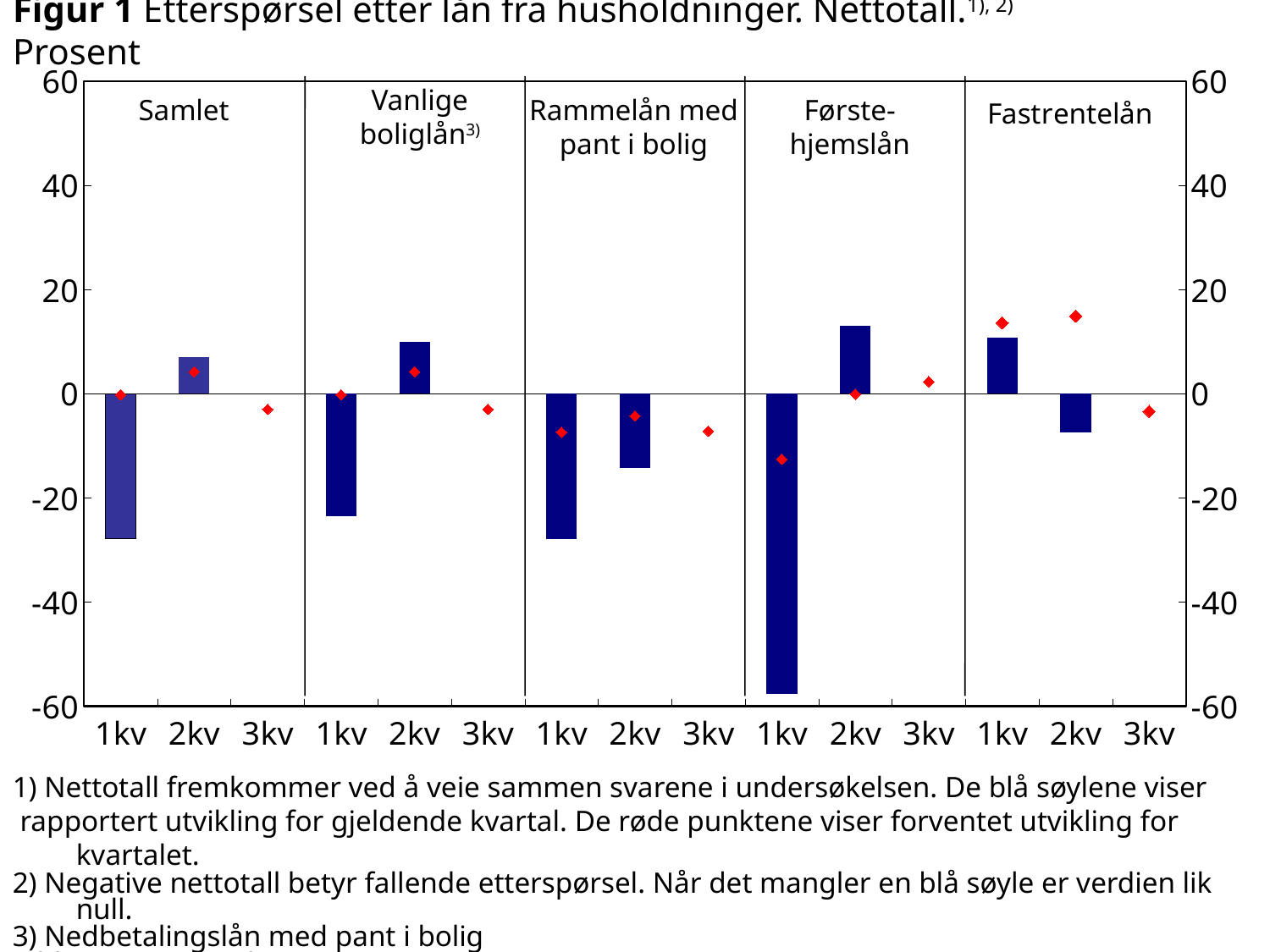
How many quarters are shown on the x axis within each panel? 3 In the Samlet panel, does the blue bar rise or fall from 1kv to 2kv? rise What kind of chart is shown in Figur 1? bar chart In the Rammelån med pant i bolig panel, which quarter has the larger blue bar value, 1kv or 2kv? 2kv Which is larger, the 2kv blue bar in the Samlet panel or the 2kv blue bar in the Førstehjemslån panel? Førstehjemslån Is the blue bar for 1kv in the Førstehjemslån panel greater or less than -40? less Is the blue bar for 2kv in the Rammelån med pant i bolig panel greater or less than -20? greater Is the blue bar for 1kv in the Samlet panel greater or less than -20? less Which panel and quarter has the lowest blue bar in the chart? Førstehjemslån, 1kv How many loan categories (panels) are shown in the chart? 5 According to the footnote, what do the red points in the chart show? Forventet utvikling for kvartalet